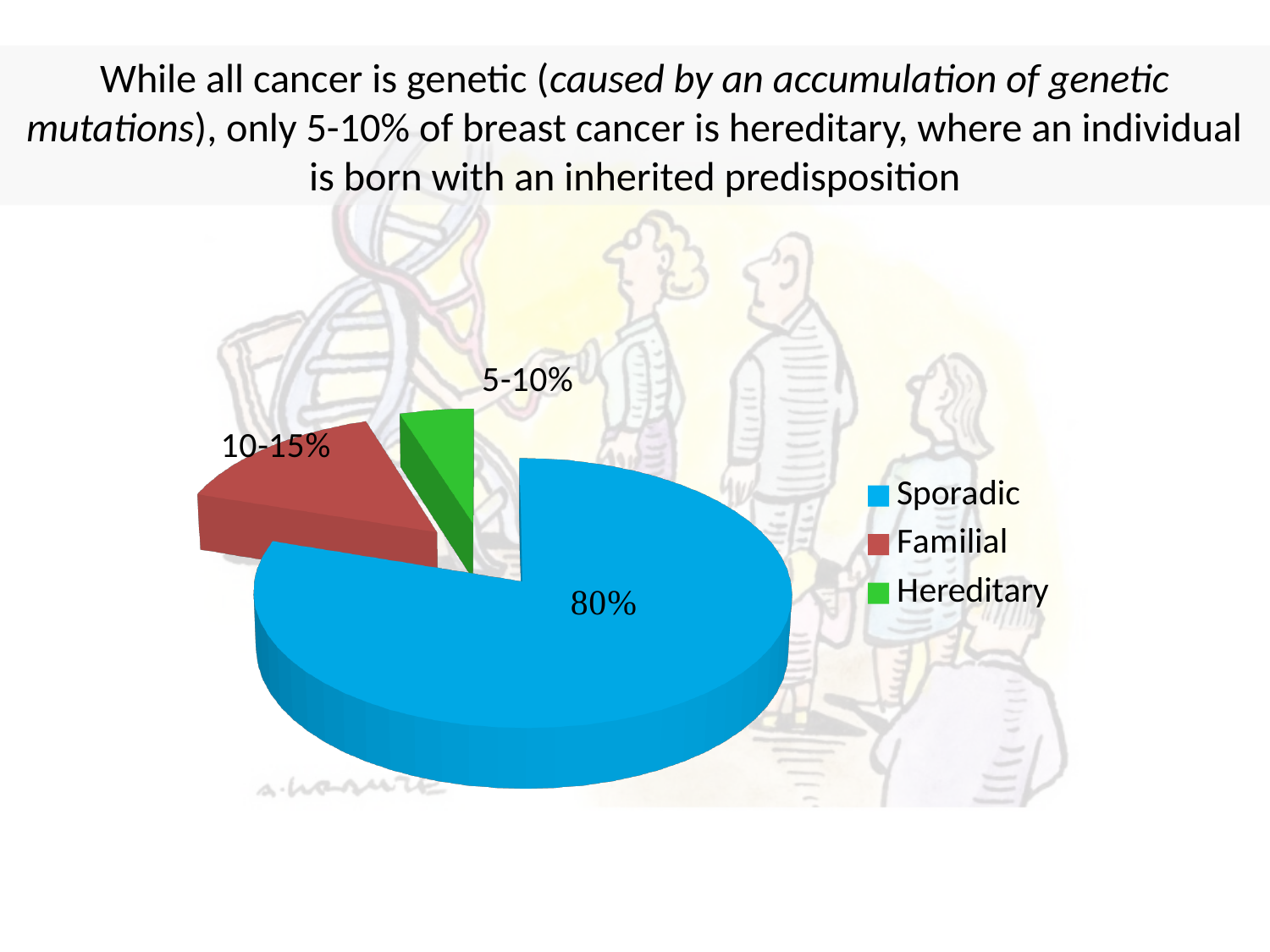
What is the label shown on the Familial slice of the pie chart? 10-15% Which category has the smallest slice of the pie chart? Hereditary What colour is the Sporadic slice in the pie chart? Blue Which category is shown in green in the pie chart legend? Hereditary What kind of chart is shown on the slide? Pie chart Which slice is larger, Familial or Hereditary? Familial Which slice is larger, Sporadic or Familial? Sporadic How many slices does the pie chart have? 3 What is the label shown on the Hereditary slice of the pie chart? 5-10% Which category has the largest slice of the pie chart? Sporadic How many entries does the legend of the pie chart list? 3 What is the label shown on the Sporadic slice of the pie chart? 80%